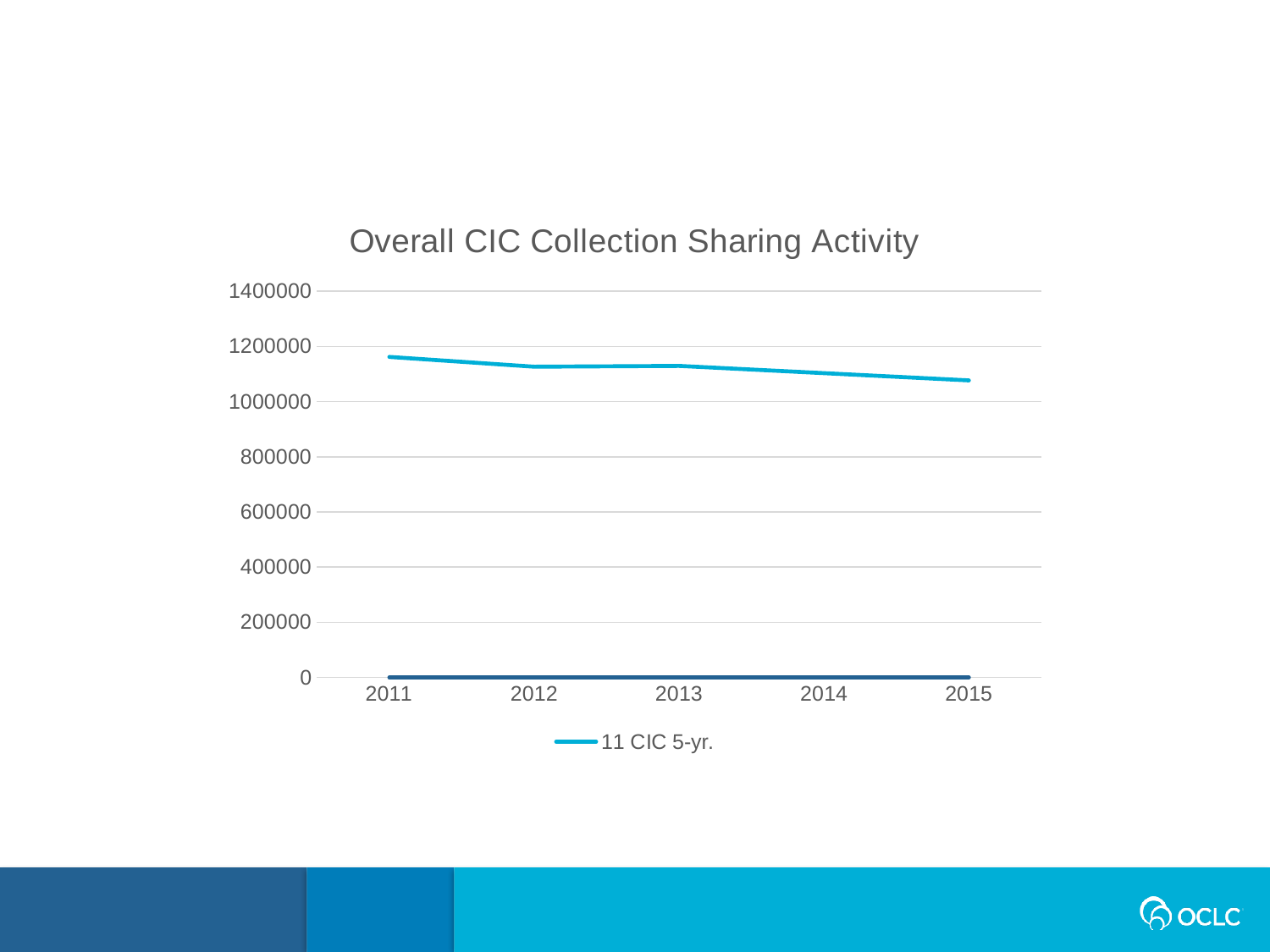
How many years are plotted along the x axis? 5 Is the value for 2011 greater or less than 1000000? greater Do the values for 11 CIC 5-yr. rise or fall from 2011 to 2015? fall Is the value for 2011 greater or less than 1200000? less What is the name of the series shown in the legend? 11 CIC 5-yr. How many series does the legend list? 1 What kind of chart is shown on the slide? line chart Which year has the lowest value for 11 CIC 5-yr.? 2015 What is the title of the chart? Overall CIC Collection Sharing Activity Which year has the highest value for 11 CIC 5-yr.? 2011 Is the value for 2015 greater or less than 1000000? greater